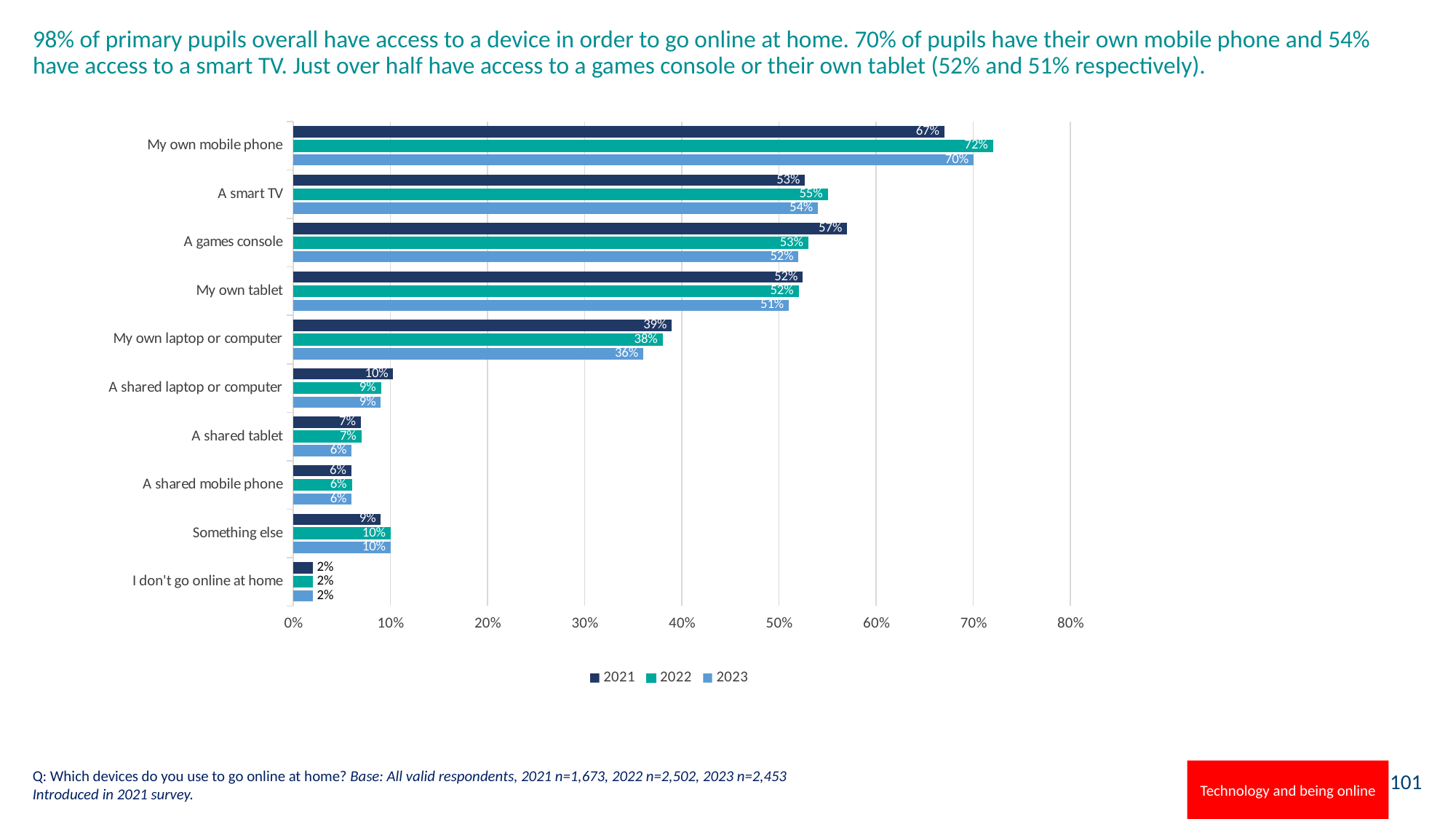
Which category has the lowest 2023 value? I don't go online at home What is the 2021 value for 'A games console'? 57% Which is larger: the 2021 value for 'A games console' or the 2021 value for 'A smart TV'? A games console What kind of chart is shown on the slide? Bar chart How many device categories are shown on the chart? 10 How many series does the legend list? 3 Which category has the highest 2022 value? My own mobile phone What is the 2022 value for 'My own laptop or computer'? 38% What is the 2023 value for 'My own mobile phone'? 70% Is the 2023 value for 'My own laptop or computer' greater or less than 40%? less Which years are listed in the chart legend? 2021, 2022, 2023 What is the difference between the 2022 and 2021 values for 'My own mobile phone'? 5%